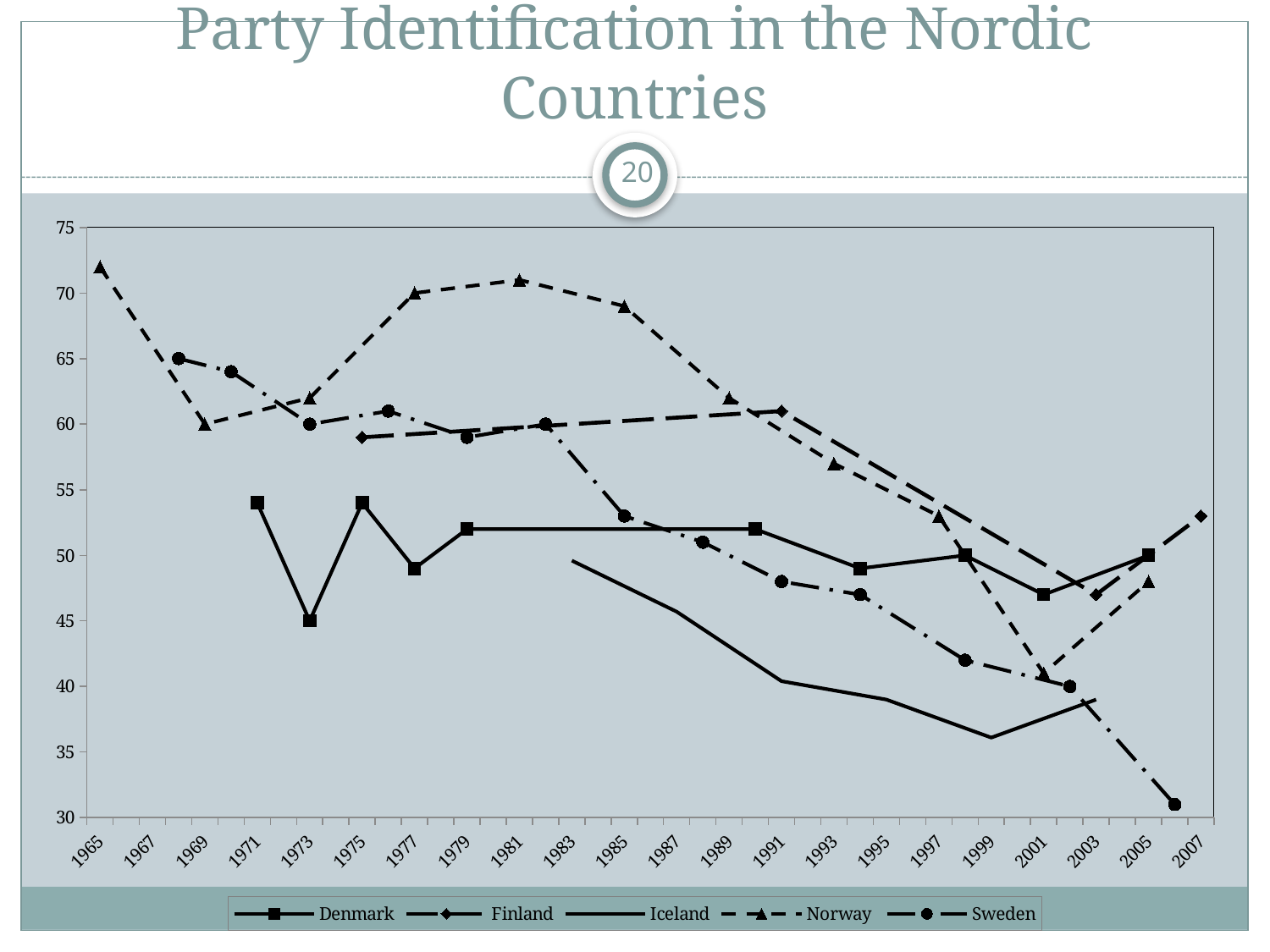
Is the value for Norway in 1985 greater or less than 65? greater Is the value for Norway in 1965 greater or less than 70? greater How many series does the legend list? 5 In 1985, which is higher, Norway or Denmark? Norway What kind of chart is shown on the slide? line chart Which countries are listed in the legend? Denmark, Finland, Iceland, Norway, Sweden Is the value for Denmark in 1973 greater or less than 50? less Does the Sweden series generally rise or fall from 1968 to 2007? fall